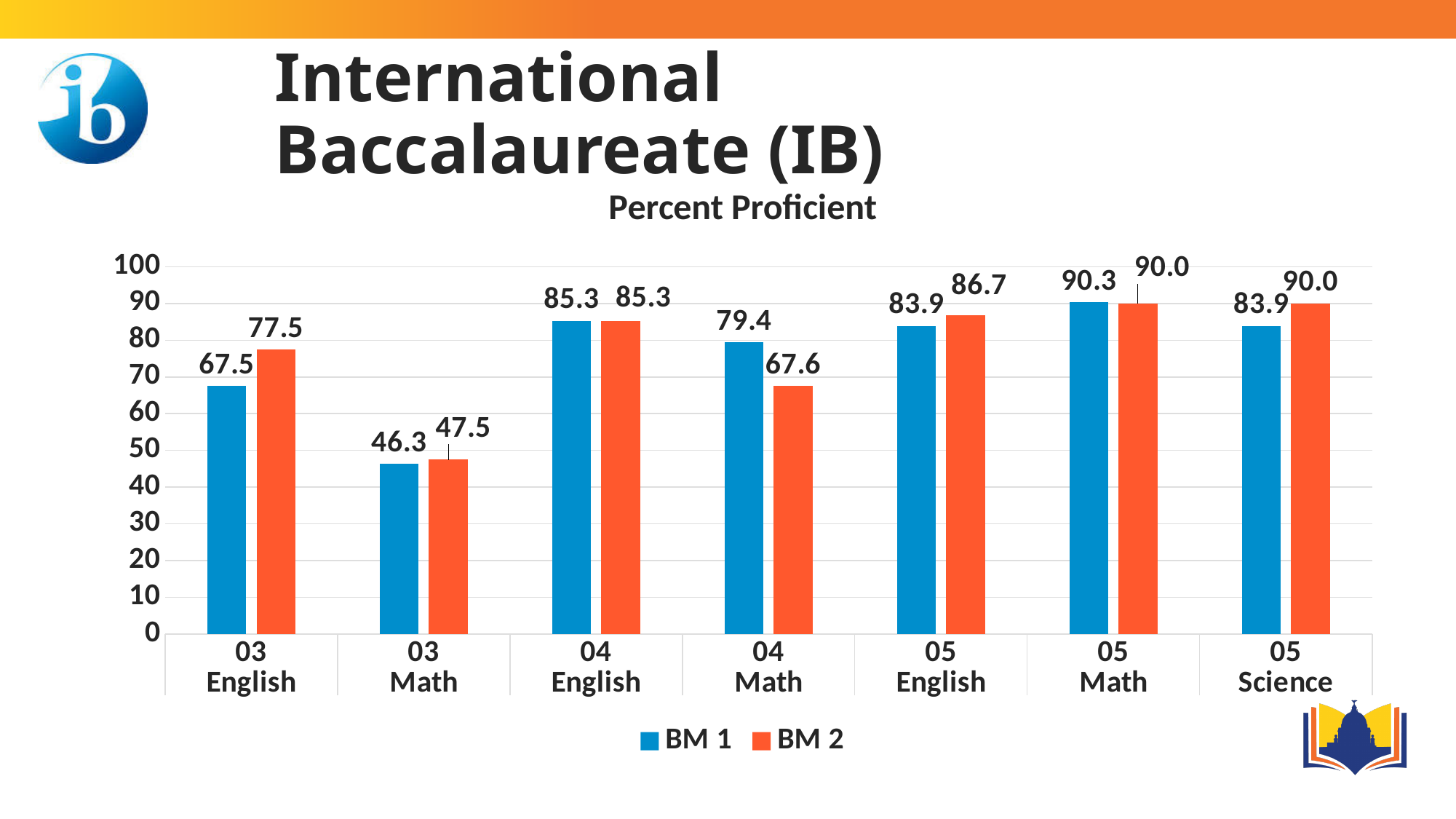
What is the difference between the BM 1 and BM 2 values for 04 Math? 11.8 What is the BM 2 value for 04 Math? 67.6 What is the BM 1 value for 03 English? 67.5 What is the difference between the BM 2 and BM 1 values for 03 English? 10.0 What is the BM 2 value for 05 Science? 90.0 Which category has the lowest BM 1 value? 03 Math Which is larger for 05 English, BM 1 or BM 2? BM 2 Which category has the highest BM 1 value? 05 Math How many categories are shown on the x axis? 7 How many series does the legend list? 2 What is the title of the chart? Percent Proficient What kind of chart is shown? Bar chart